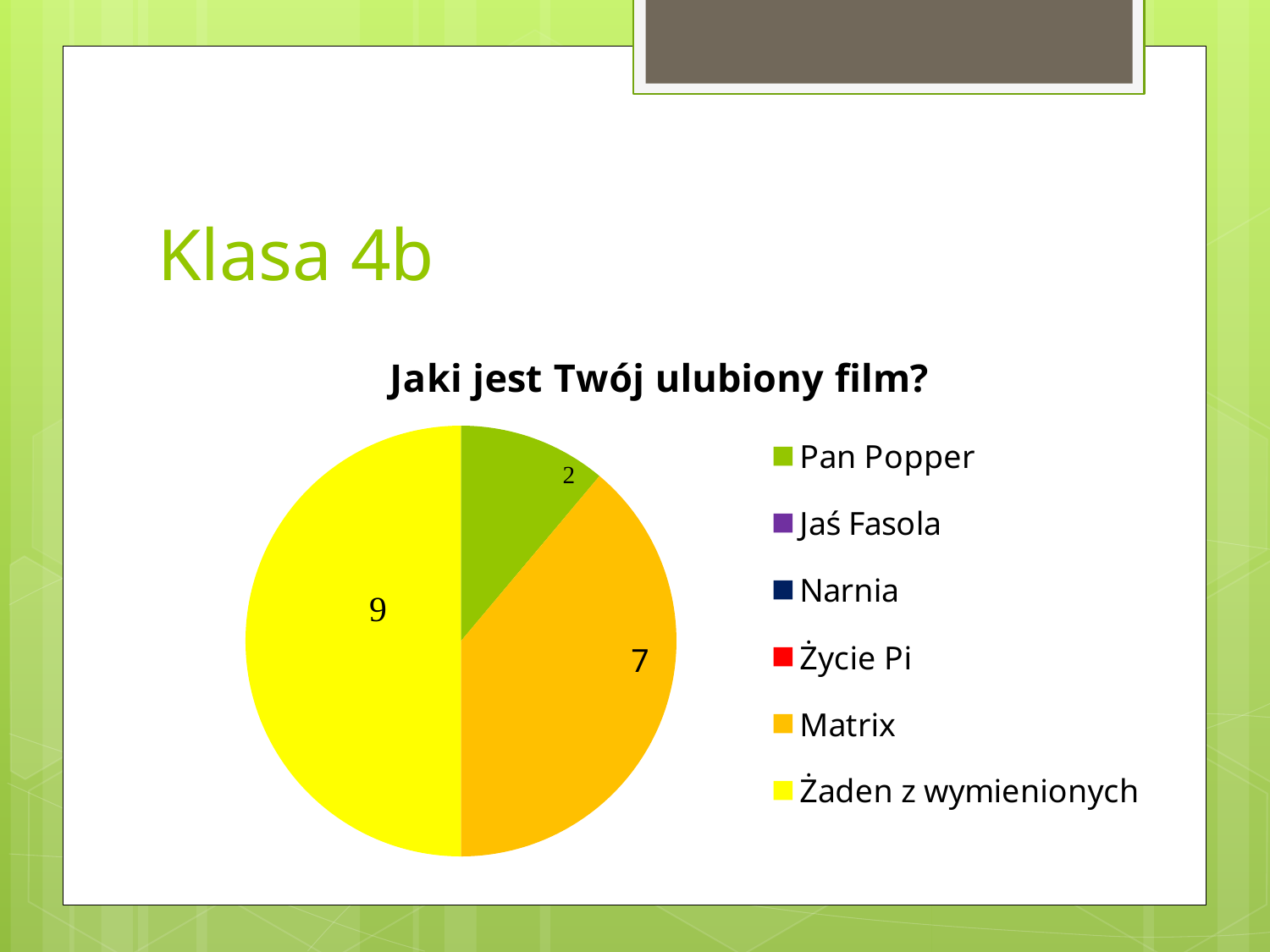
What is the title of the chart? Jaki jest Twój ulubiony film? What type of chart is shown on the slide? pie chart What is the value for Matrix? 7 Which is larger, the value for Matrix or the value for Pan Popper? Matrix Which category has the largest slice? Żaden z wymienionych How many slices are visible in the pie chart? 3 What is the value for Żaden z wymienionych? 9 Which of the visible slices is the smallest? Pan Popper What share of the pie does Żaden z wymienionych represent? 50% What is the difference between the values for Żaden z wymienionych and Matrix? 2 How many entries does the chart's legend list? 6 What is the value for Pan Popper? 2